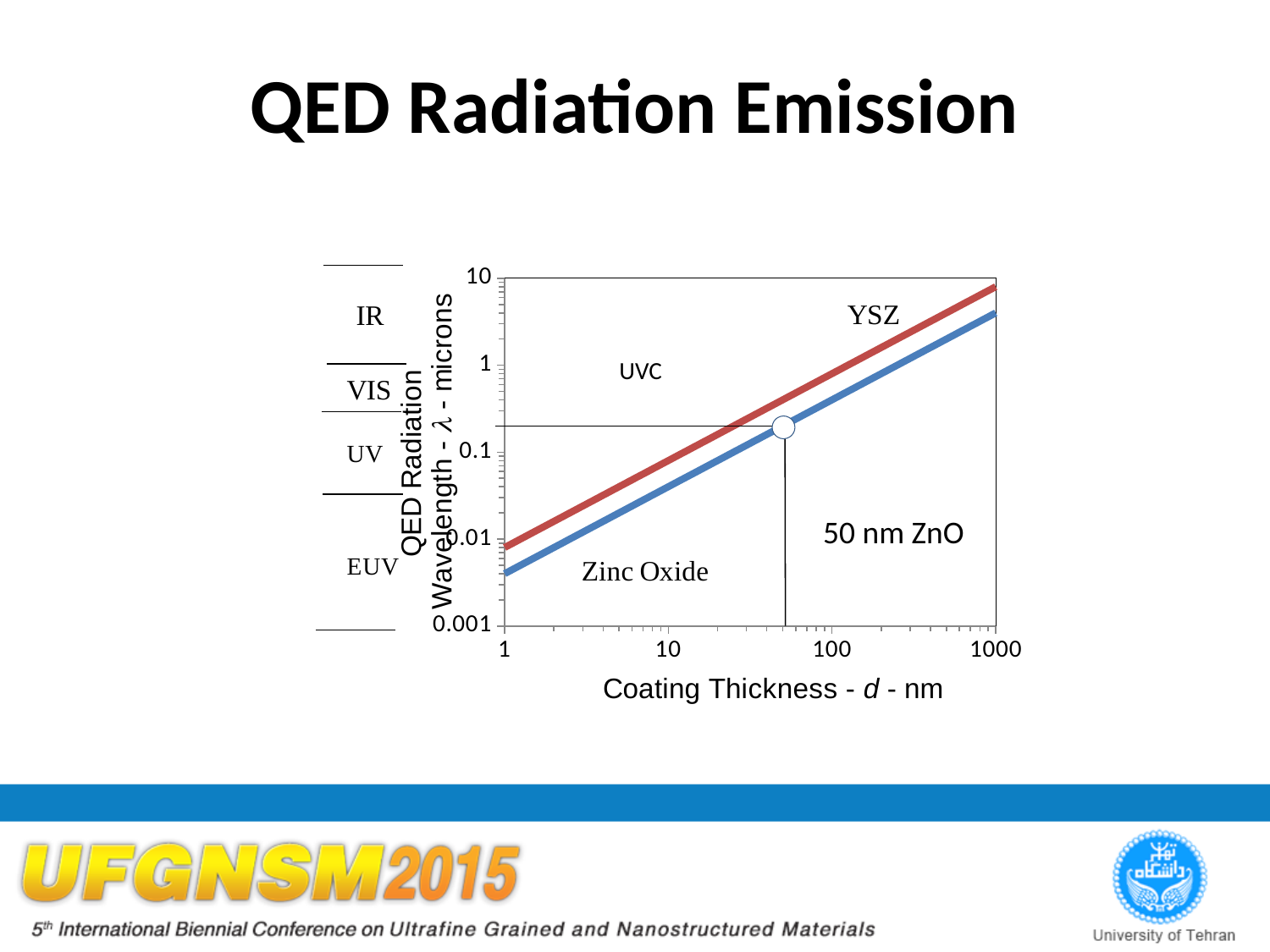
Does the QED radiation wavelength rise or fall as coating thickness increases? rise At a coating thickness of 100 nm, which line has the higher wavelength, YSZ or Zinc Oxide? YSZ Is the wavelength for Zinc Oxide at a coating thickness of 1 nm greater or less than 0.01 microns? less Is the wavelength for Zinc Oxide at a coating thickness of 50 nm greater or less than 1 micron? less Is the wavelength for YSZ at a coating thickness of 1000 nm greater or less than 1 micron? greater How many lines (series) are plotted on the chart? 2 What coating thickness is marked by the circled point and annotation on the Zinc Oxide line? 50 nm What kind of chart is shown on the slide? line chart Which two materials are labelled on the plotted lines? YSZ and Zinc Oxide What is the title of the x axis? Coating Thickness - d - nm